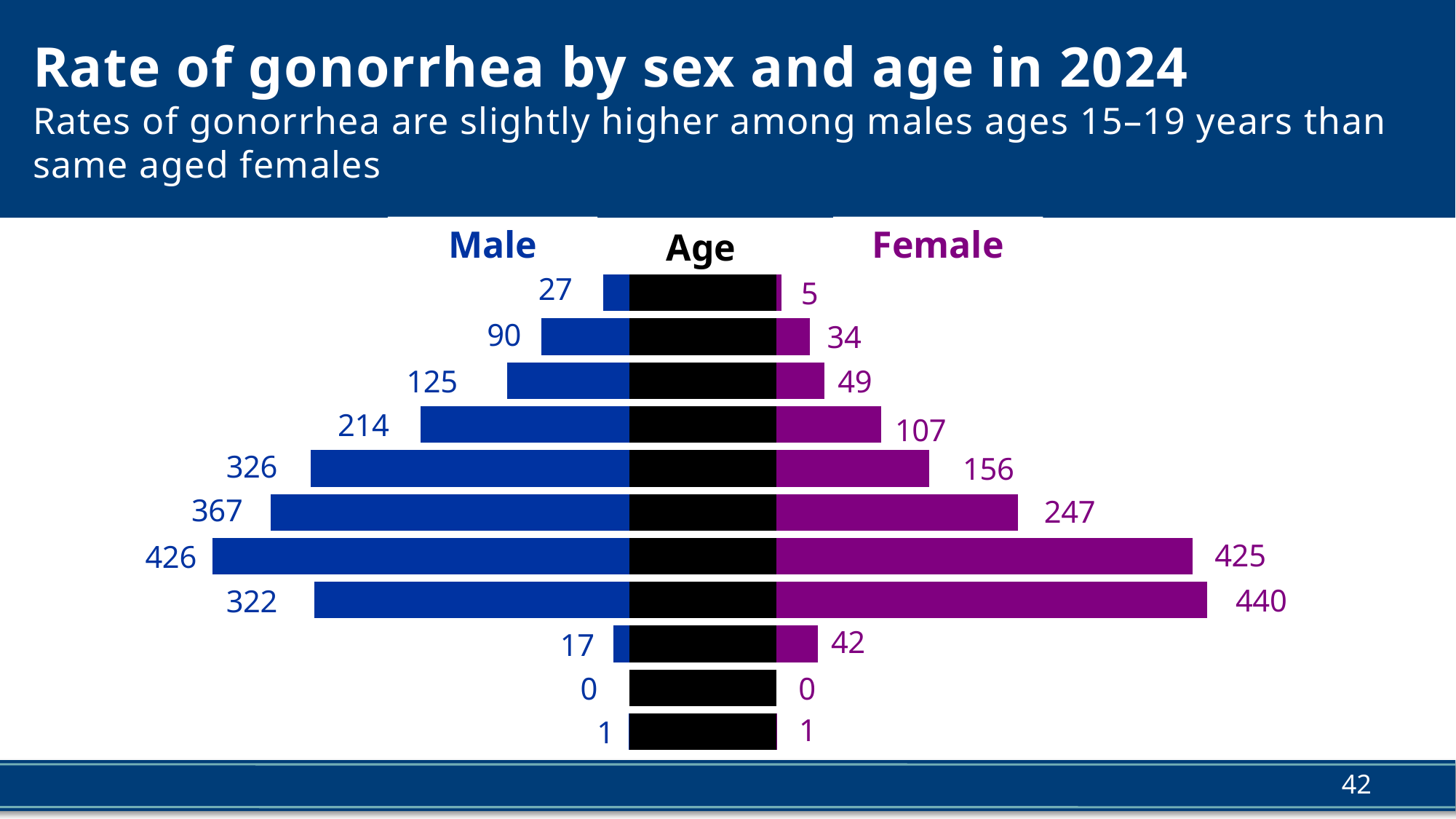
What kind of chart is shown on the slide? bar chart In the row where the Male value is 426, what is the Female value? 425 What is the highest Male value shown in the chart? 426 In the row where the Female value is 440, which is larger, the Male value or the Female value? Female What is the difference between the Female value of 440 and the Male value of 322 in the same row? 118 What is the difference between the Male value of 426 and the Female value of 425 in the same row? 1 What is the Female value in the top row of the chart? 5 What is the highest Female value shown in the chart? 440 What is the Male value in the top row of the chart? 27 How many age rows (bars per side) are plotted in the chart? 11 What is the title of the chart on the slide? Rate of gonorrhea by sex and age in 2024 How many series (sexes) does the chart show? 2